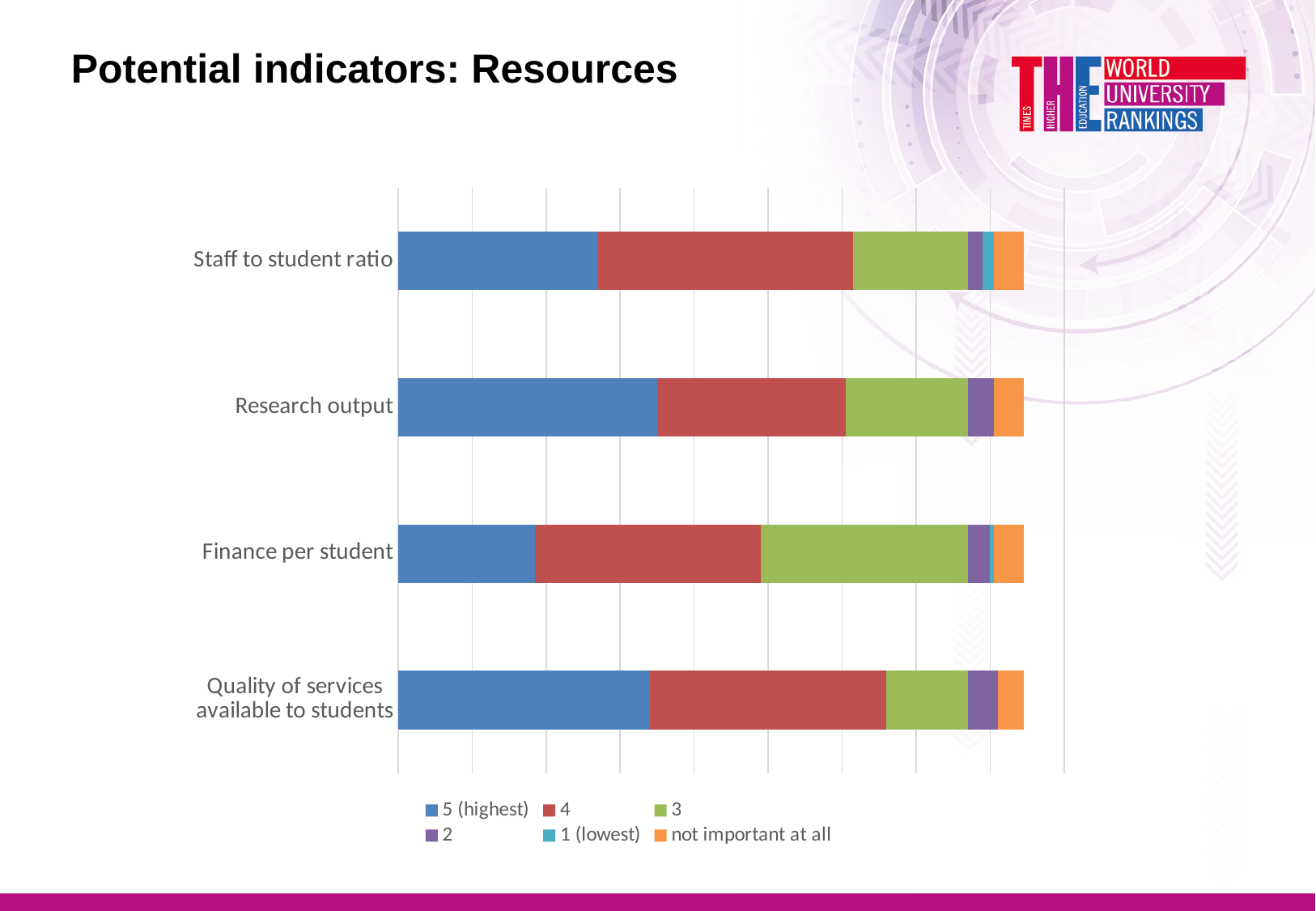
Which category has the smallest '5 (highest)' segment? Finance per student Which category has the smallest '3' segment? Quality of services available to students Which legend entry is shown in orange? not important at all What kind of chart is shown on the slide? Stacked bar chart How many categories (indicators) are plotted on the chart? 4 How many series does the legend list? 6 Is the '4' segment larger for Research output or for Finance per student? Finance per student Which category has the largest '3' segment? Finance per student What is the title of the slide containing the chart? Potential indicators: Resources Is the '3' segment larger for Finance per student or for Research output? Finance per student Is the '5 (highest)' segment larger for Staff to student ratio or for Finance per student? Staff to student ratio Which category has the smallest '4' segment? Research output